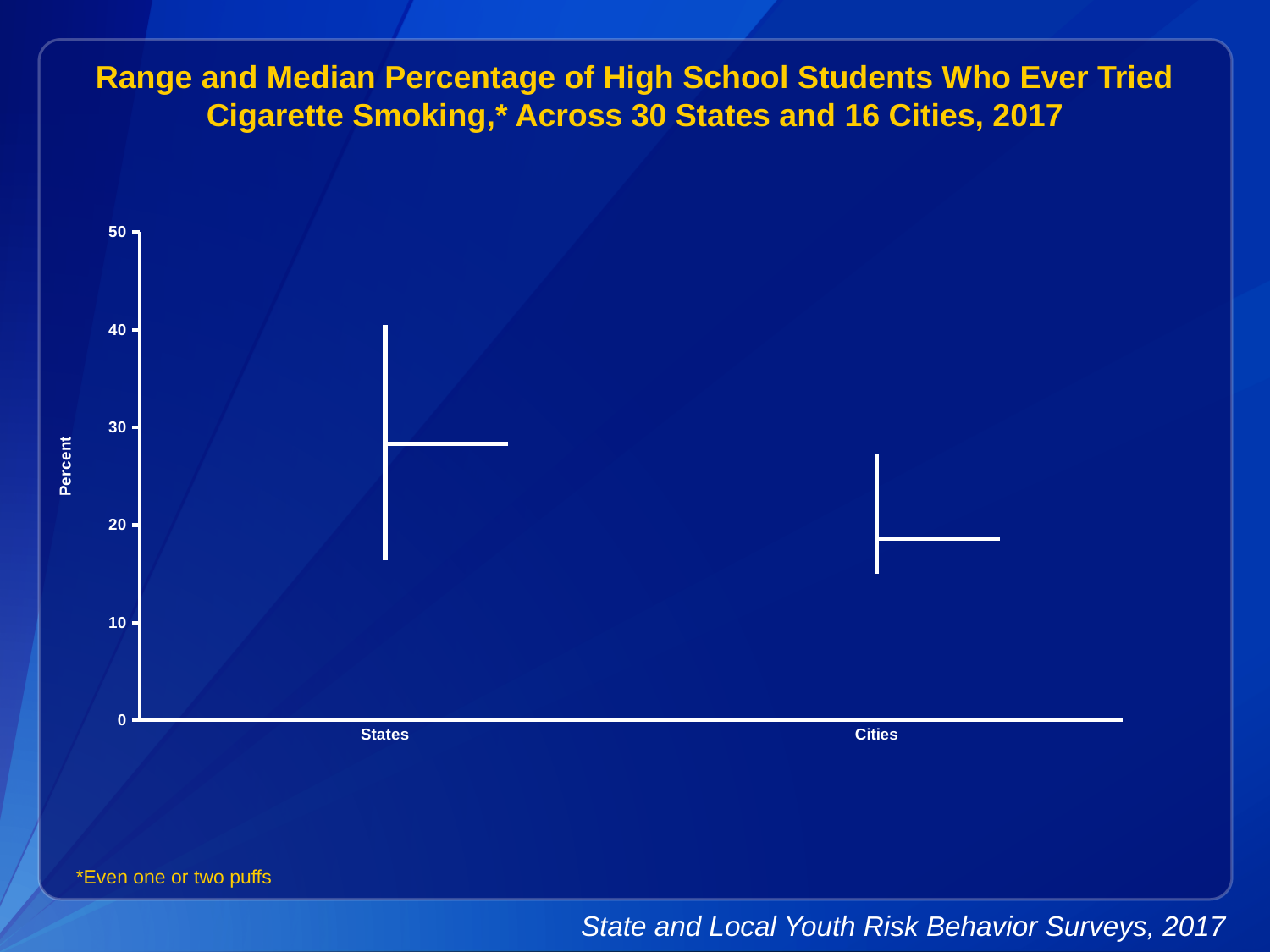
Is the bottom of the range for Cities greater or less than 20? less What is the label of the y axis? Percent What are the two categories shown on the x axis? States and Cities Is the median value for States greater or less than 30? less Is the top of the range for Cities greater or less than 20? greater How many categories are shown on the x axis of the chart? 2 Which has the higher median percentage, States or Cities? States Which category has the higher top of its range, States or Cities? States